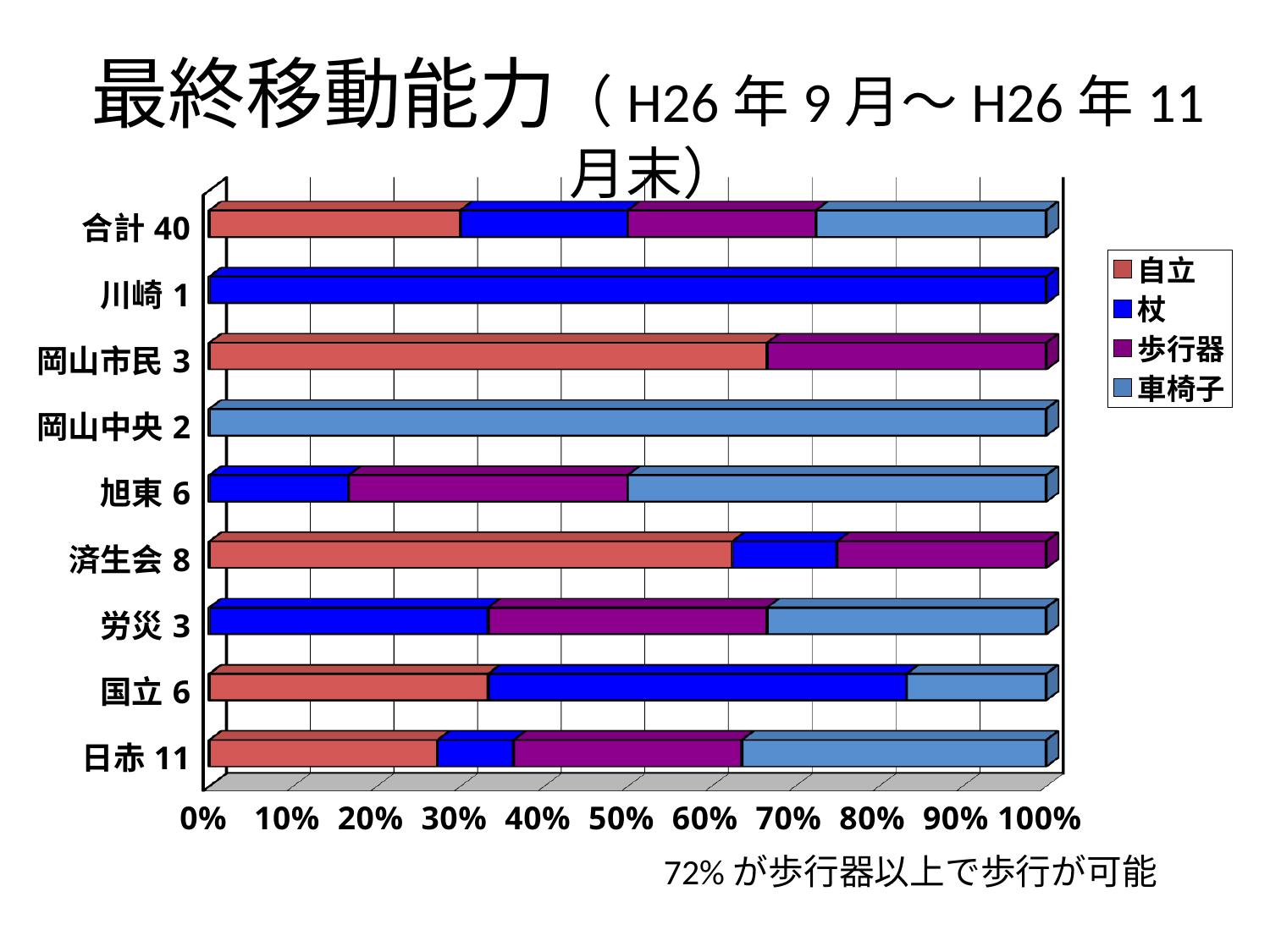
Is the 自立 share for 合計 40 greater or less than 40%? less What percentage does the note below the chart say can walk with a walker or better? 72% Is the 杖 share for 旭東 6 greater or less than 20%? less What percentage of the 川崎 1 bar is 杖? 100% Which series is listed first in the legend? 自立 Which series makes up the entire bar for 岡山中央 2? 車椅子 Is the 自立 share for 岡山市民 3 greater or less than 60%? greater Which series makes up the entire bar for 川崎 1? 杖 What kind of chart is shown on the slide? stacked bar chart How many series does the legend list? 4 How many categories (rows) are plotted on the chart? 9